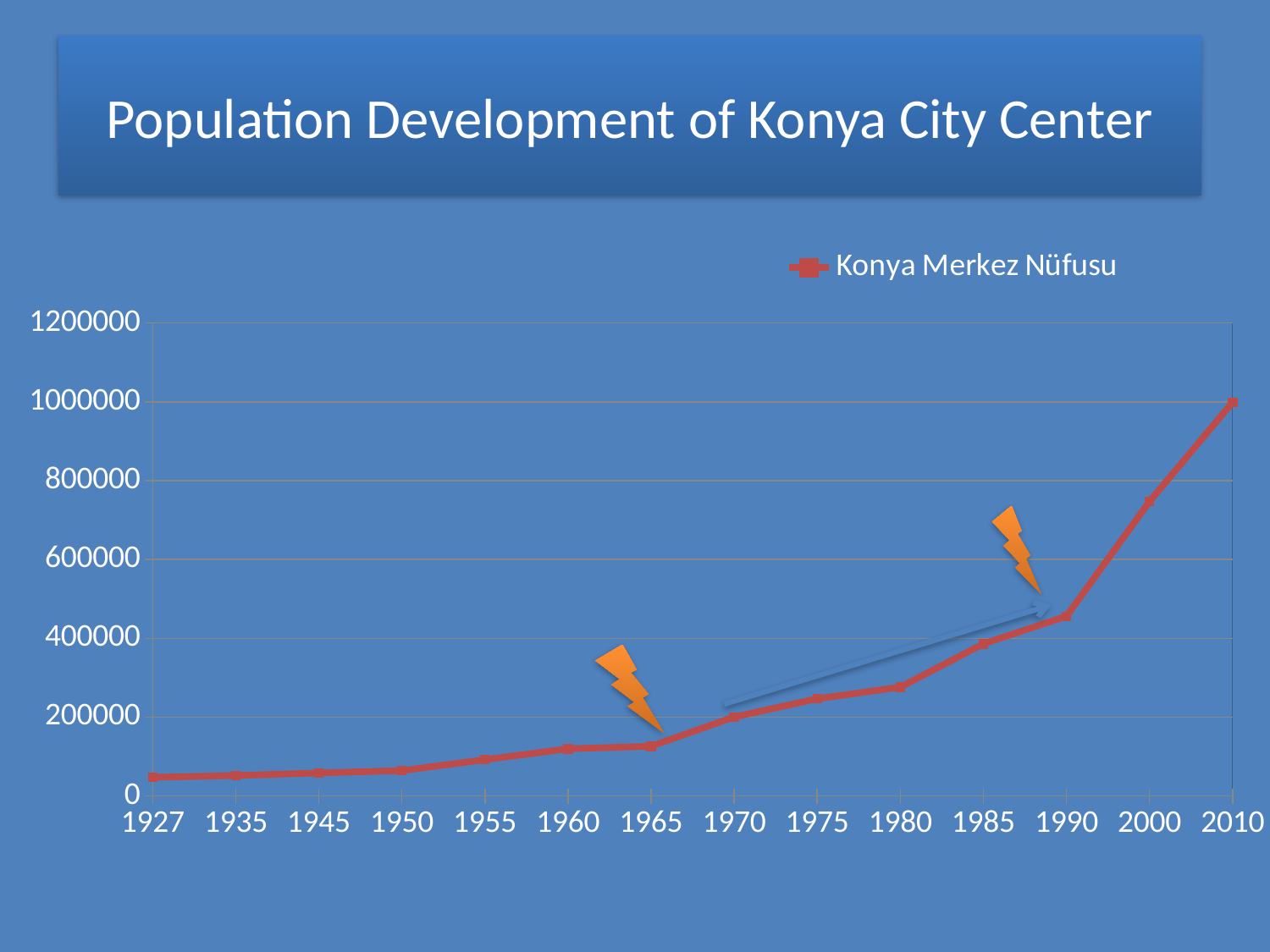
Is the value for 1960 greater or less than 200000? less Is the value for 1990 greater or less than 400000? greater Do the population values generally rise or fall from 1927 to 2010? Rise What series name does the legend show? Konya Merkez Nüfusu How many years are plotted along the x axis? 14 Which year has the larger population value, 1990 or 2000? 2000 Is the value for 1980 greater or less than 400000? less What kind of chart is shown on the slide? Line chart Which year has the highest population value? 2010 How many series does the legend list? 1 What is the title of the slide's chart? Population Development of Konya City Center